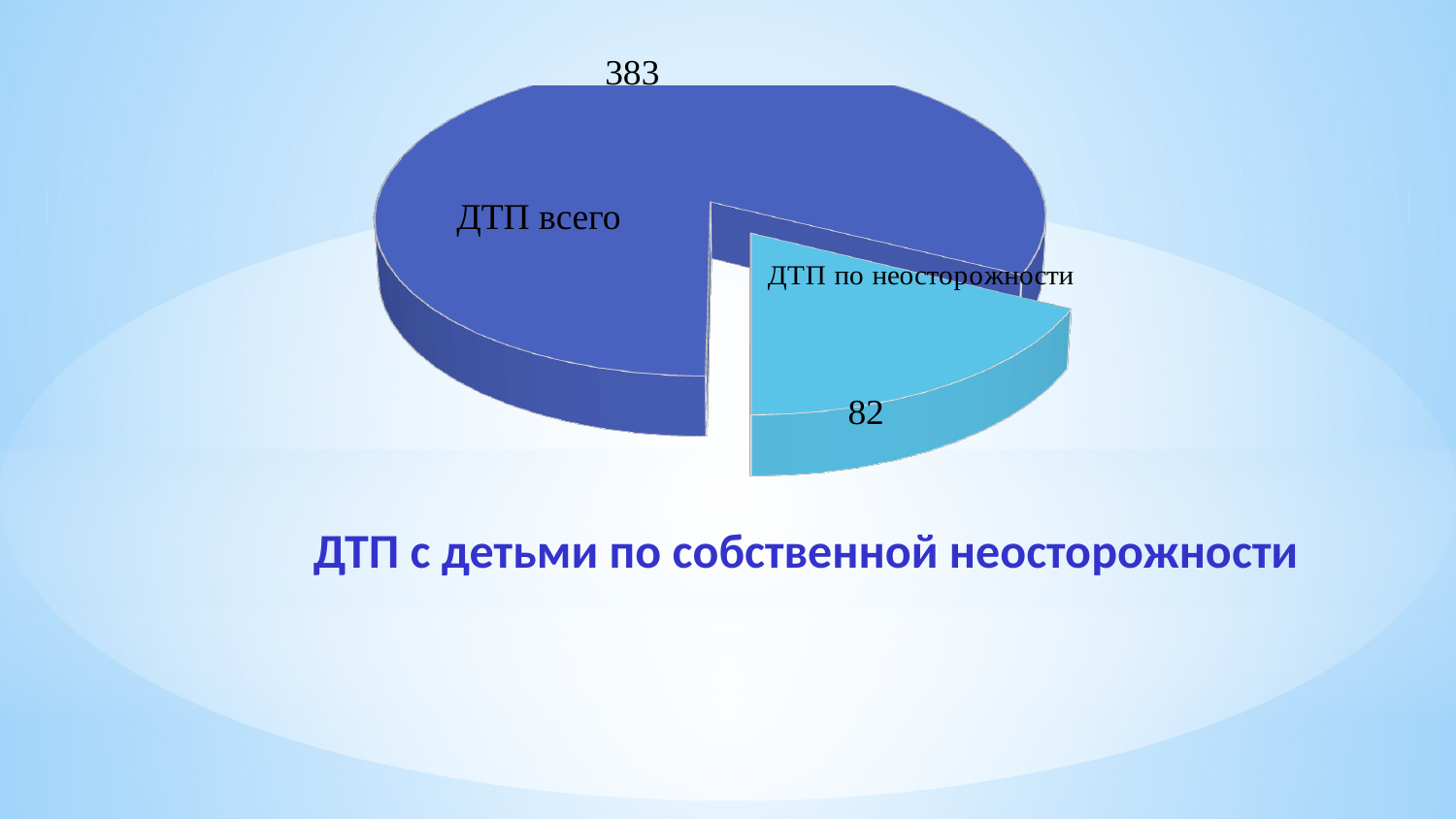
Which slice of the pie chart is the smallest? ДТП по неосторожности Which slice of the pie chart is the largest? ДТП всего What colour is the "ДТП по неосторожности" slice? Light blue Which is larger: the value for "ДТП всего" or the value for "ДТП по неосторожности"? ДТП всего What value is shown for the "ДТП по неосторожности" slice? 82 What is the difference between the values for "ДТП всего" and "ДТП по неосторожности"? 301 What value is shown for the "ДТП всего" slice? 383 What is the sum of the two values shown on the pie chart? 465 What kind of chart is shown on the slide? Pie chart What is the title text shown below the chart? ДТП с детьми по собственной неосторожности How many slices does the pie chart have? 2